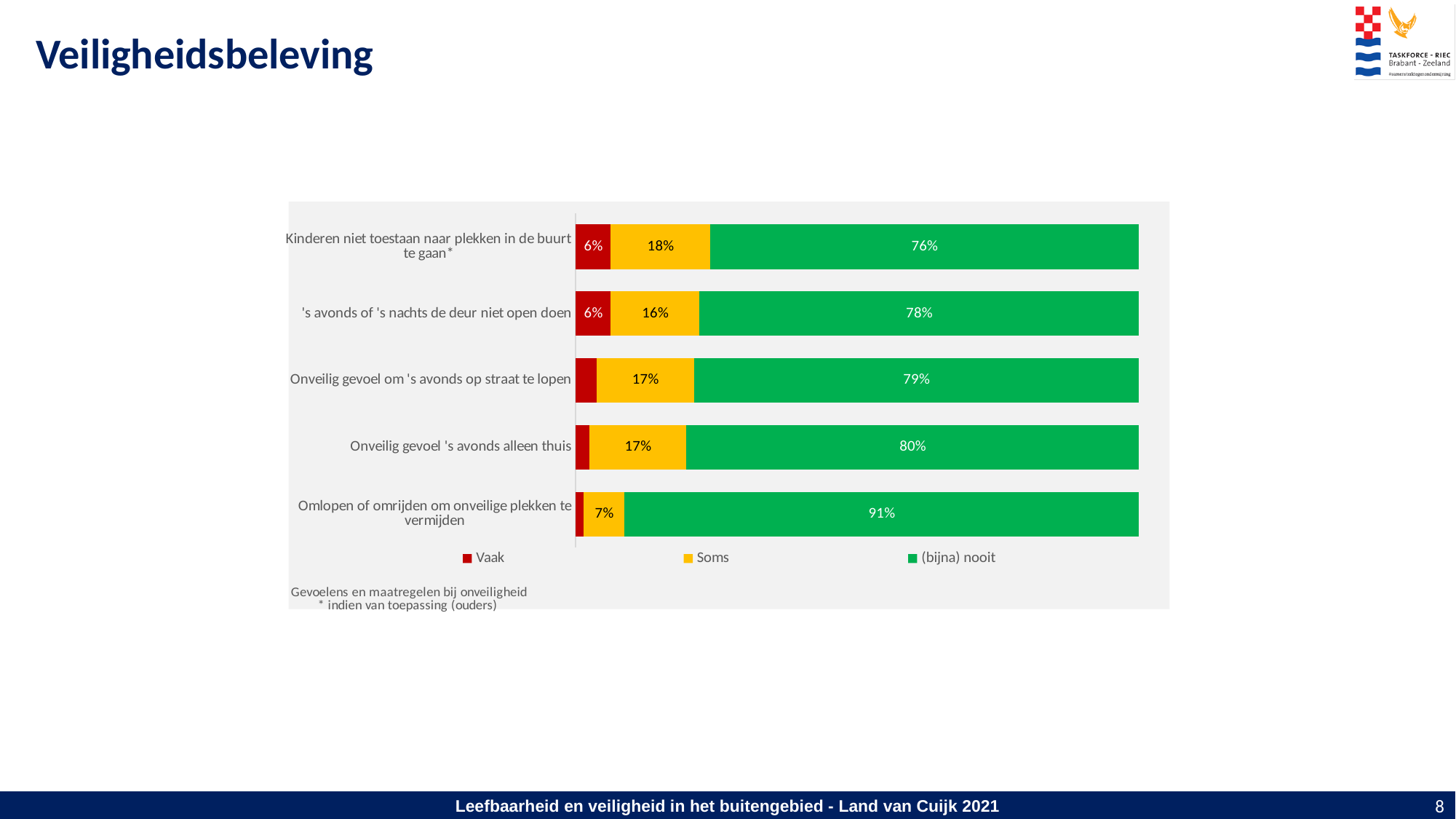
What is the 'Soms' value for 'Kinderen niet toestaan naar plekken in de buurt te gaan*'? 18% Which category has the highest '(bijna) nooit' value? Omlopen of omrijden om onveilige plekken te vermijden What is the 'Vaak' value for ''s avonds of 's nachts de deur niet open doen'? 6% How many categories are plotted in the chart? 5 Which category has the lowest '(bijna) nooit' value? Kinderen niet toestaan naar plekken in de buurt te gaan* What is the difference between the '(bijna) nooit' values for 'Omlopen of omrijden om onveilige plekken te vermijden' and 'Onveilig gevoel om 's avonds op straat te lopen'? 12% How many series does the legend list? 3 Which legend entry is shown in green? (bijna) nooit What is the '(bijna) nooit' value for 'Onveilig gevoel 's avonds alleen thuis'? 80% What kind of chart is shown on the slide? stacked bar chart Which is larger: the 'Soms' value for 'Kinderen niet toestaan naar plekken in de buurt te gaan*' or for ''s avonds of 's nachts de deur niet open doen'? Kinderen niet toestaan naar plekken in de buurt te gaan* What is the '(bijna) nooit' value for 'Omlopen of omrijden om onveilige plekken te vermijden'? 91%